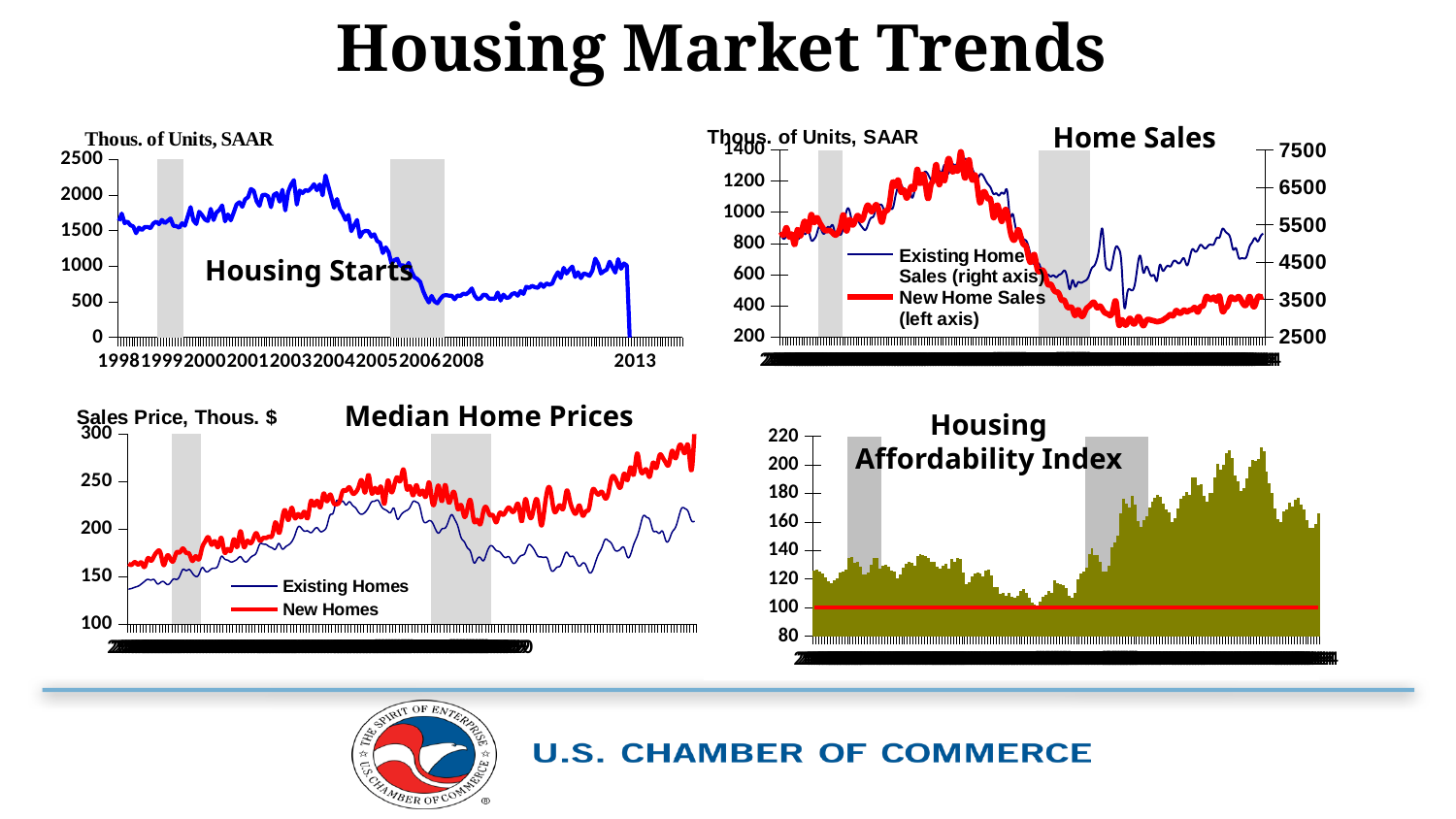
What kind of chart is the Housing Starts chart? line chart In the Housing Starts chart, is the highest value reached greater or less than 2000? greater In the Median Home Prices chart, is the final value of New Homes greater or less than 250? greater How many series does the legend of the Median Home Prices chart list? 2 In the Housing Starts chart, is the value at the 2008 label greater or less than 1000? less In the Median Home Prices chart, which series is higher at the right end of the chart, Existing Homes or New Homes? New Homes In the Home Sales chart, which series is plotted on the left axis according to the legend? New Home Sales Do the New Homes prices in the Median Home Prices chart rise or fall overall from left to right? rise How many series does the legend of the Home Sales chart list? 2 What kind of chart is the Housing Affordability Index chart? bar chart